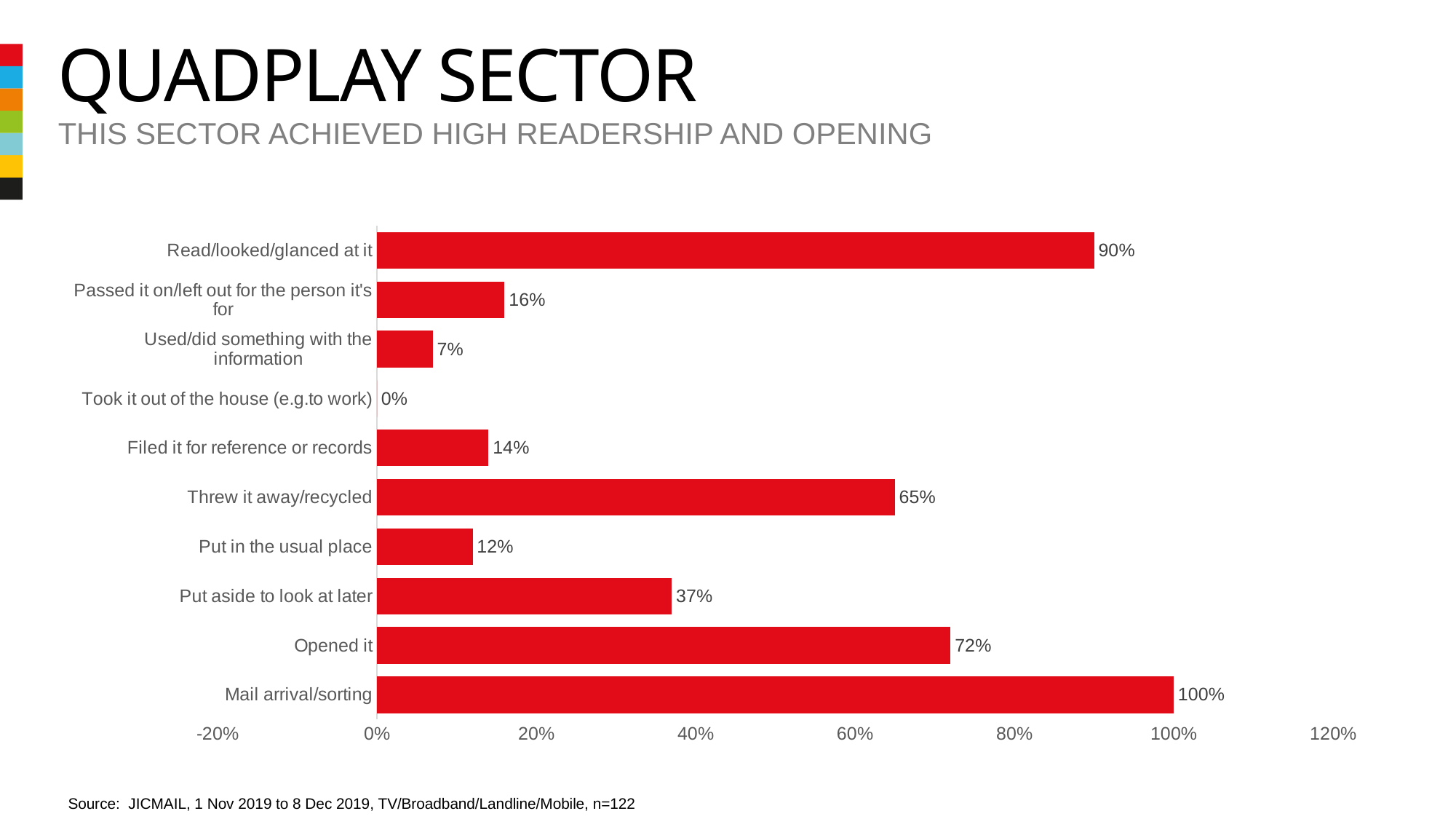
How many categories are shown in the chart? 10 What is the difference between "Threw it away/recycled" and "Put aside to look at later"? 28% What kind of chart is shown on the slide? Bar chart Which category has the lowest value? Took it out of the house (e.g.to work) What is the value for "Used/did something with the information"? 7% Which category has the highest value? Mail arrival/sorting Which is larger, "Passed it on/left out for the person it's for" or "Filed it for reference or records"? Passed it on/left out for the person it's for What colour are the bars in the chart? Red What is the value for "Threw it away/recycled"? 65% What is the difference between "Read/looked/glanced at it" and "Opened it"? 18% What is the value for "Put aside to look at later"? 37% What is the value for "Opened it"? 72%